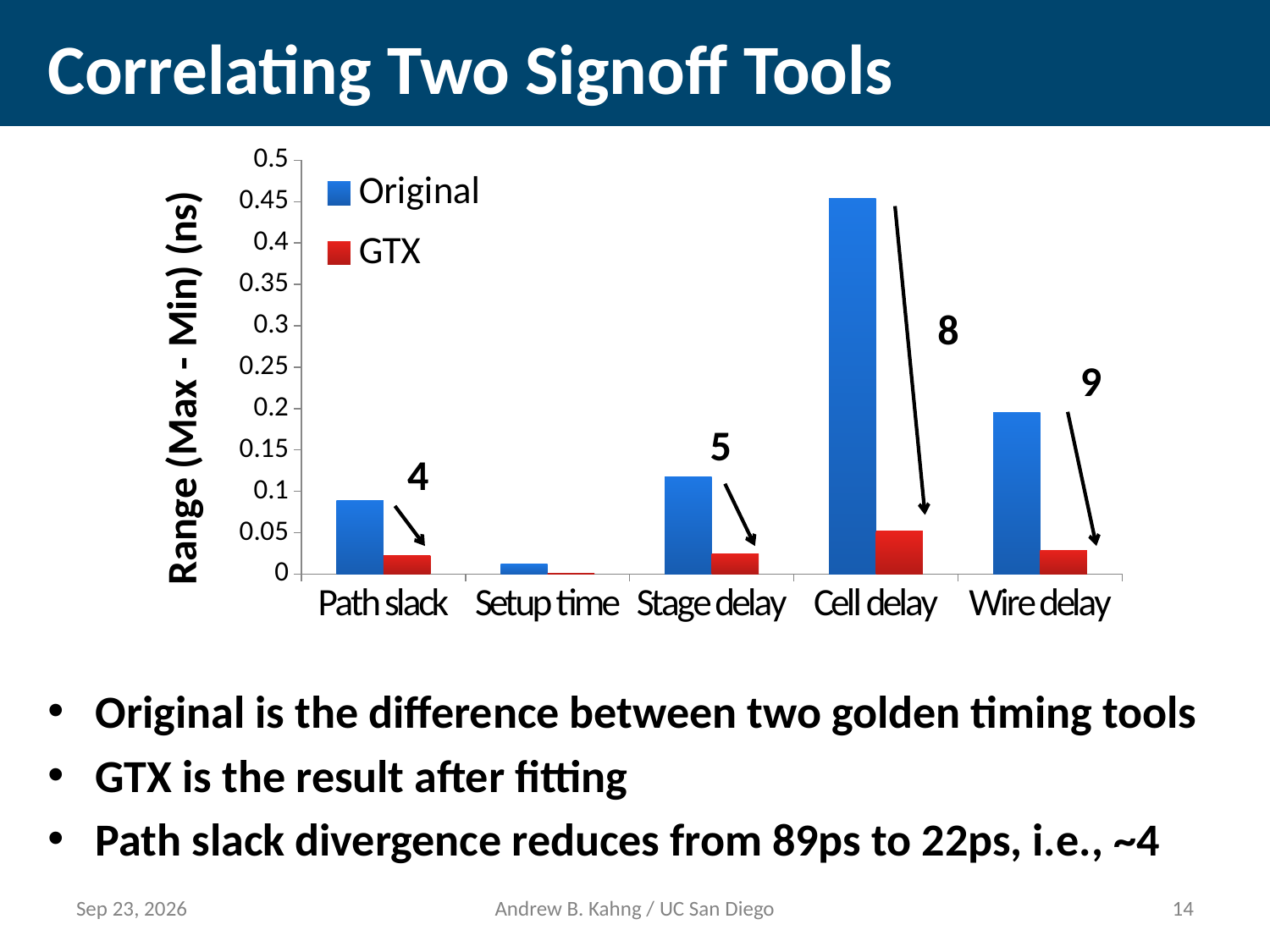
Which category has the highest GTX value? Cell delay Which category has the lowest Original value? Setup time Is the Original value for Cell delay greater or less than 0.4? greater What is the label of the chart's y axis? Range (Max - Min) (ns) How many categories are shown on the x axis of the chart? 5 For Cell delay, which is larger: the Original value or the GTX value? Original Which category has the highest Original value? Cell delay Is the GTX value for Cell delay greater or less than 0.1? less Is the Original value for Stage delay greater or less than 0.1? greater What number is annotated next to the arrow for Cell delay? 8 How many series does the chart's legend list? 2 What kind of chart is shown on the slide? bar chart